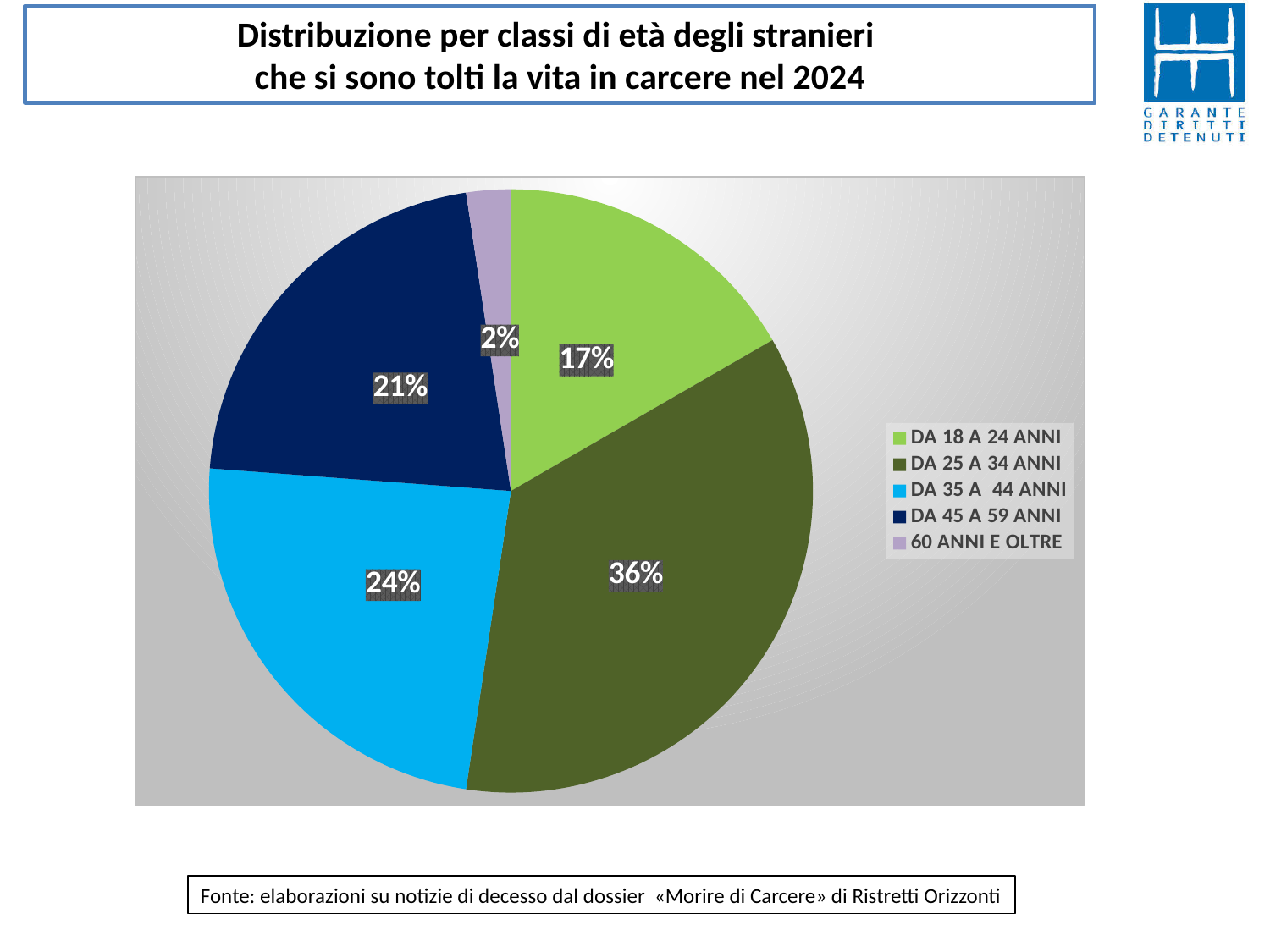
What is the difference in percentage points between DA 25 A 34 ANNI and DA 18 A 24 ANNI? 19 What is the value shown for 60 ANNI E OLTRE? 2% What share of the pie does the DA 25 A 34 ANNI slice represent? 36% What is the value shown for DA 18 A 24 ANNI? 17% What type of chart is shown on the slide? pie chart What is the value shown for DA 45 A 59 ANNI? 21% Which age class has the smallest slice of the pie? 60 ANNI E OLTRE What colour is the slice for DA 45 A 59 ANNI? dark blue Which is larger, the slice for DA 35 A 44 ANNI or the slice for DA 45 A 59 ANNI? DA 35 A 44 ANNI Which age class has the largest slice of the pie? DA 25 A 34 ANNI What is the value shown for DA 35 A 44 ANNI? 24% How many age classes are shown in the pie chart? 5